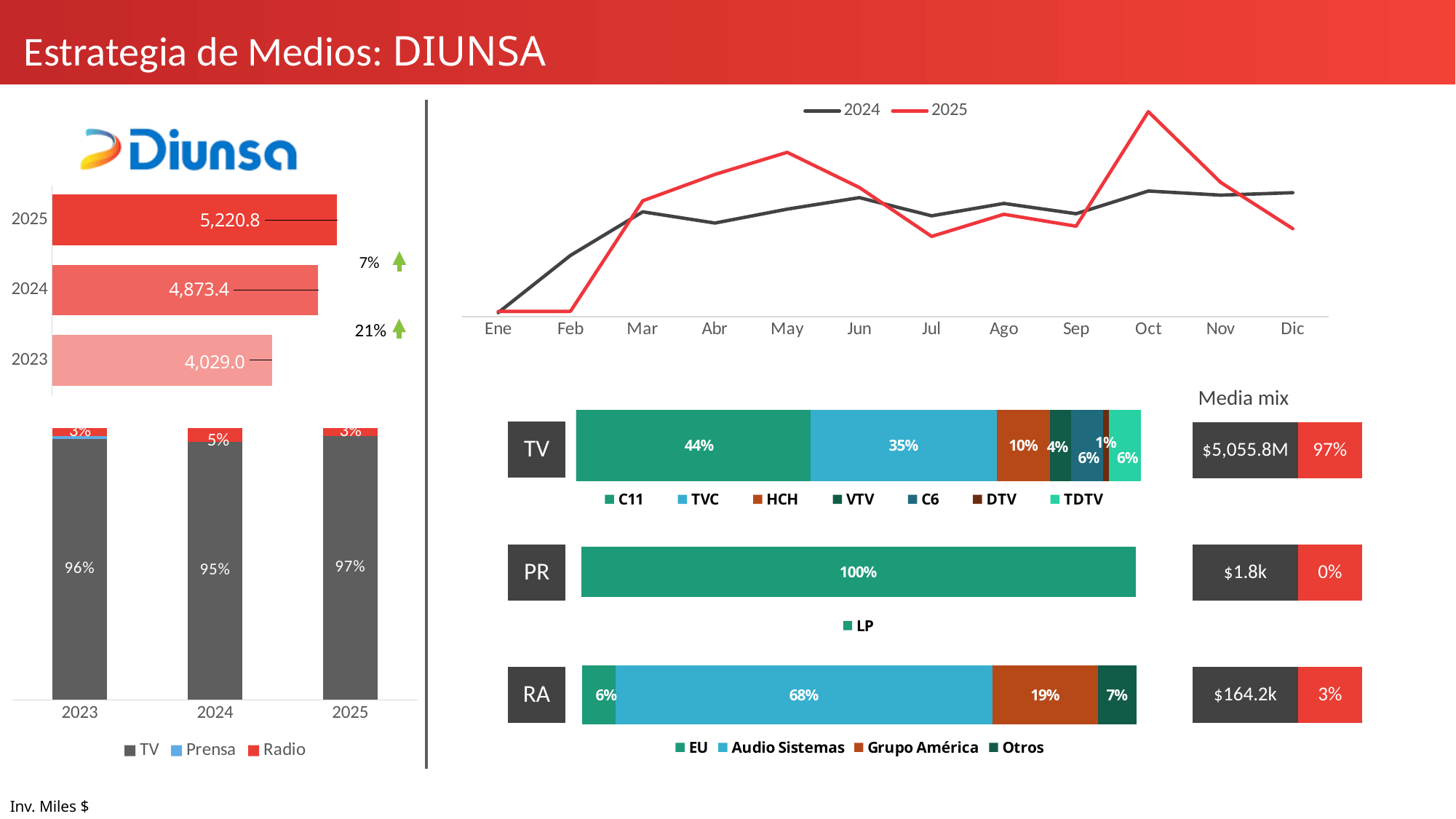
In the yearly investment bar chart on the left, what is the value for 2023? 4,029.0 In the yearly investment bar chart on the left, what is the difference between the 2025 and 2024 values? 347.4 In the yearly investment bar chart on the left, which year has the lowest value? 2023 In the stacked bar chart at the bottom left, what is the TV share for 2024? 95% In the monthly line chart at the top right, which series has the higher value in Oct, 2024 or 2025? 2025 In the yearly investment bar chart on the left, do the values rise or fall from 2023 to 2025? rise In the yearly investment bar chart on the left, what is the value for 2025? 5,220.8 In the Media mix table, what percentage is shown for TV? 97% In the stacked bar chart at the bottom left, how many series does the legend list? 3 In the RA stacked bar, which channel has the largest share? Audio Sistemas In the monthly line chart at the top right, how many series does the legend list? 2 In the TV stacked bar, what is the share for C11? 44%